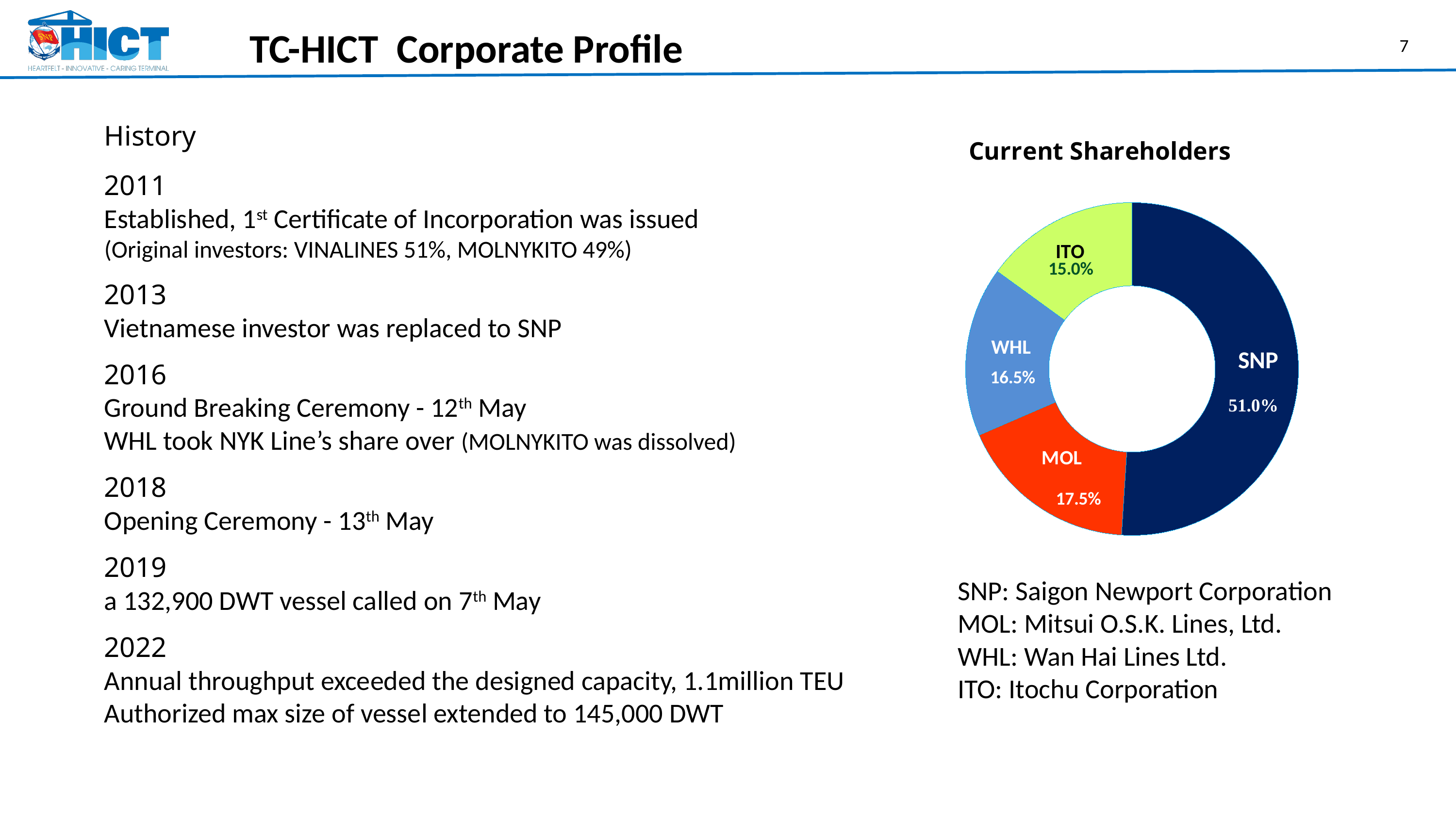
In the Current Shareholders chart, which is larger, the share of WHL or the share of ITO? WHL What kind of chart is the Current Shareholders chart? Pie chart (doughnut) How many shareholders are shown in the Current Shareholders chart? 4 What is the difference between the SNP share and the MOL share in the Current Shareholders chart? 33.5% Which shareholder has the largest share in the Current Shareholders chart? SNP What is the title of the chart on the slide? Current Shareholders What share of the Current Shareholders chart does MOL hold? 17.5% Which shareholder has the smallest share in the Current Shareholders chart? ITO What share of the Current Shareholders chart does WHL hold? 16.5% What is the difference between the MOL share and the WHL share in the Current Shareholders chart? 1.0% What share of the Current Shareholders chart does ITO hold? 15.0% What share of the Current Shareholders chart does SNP hold? 51.0%